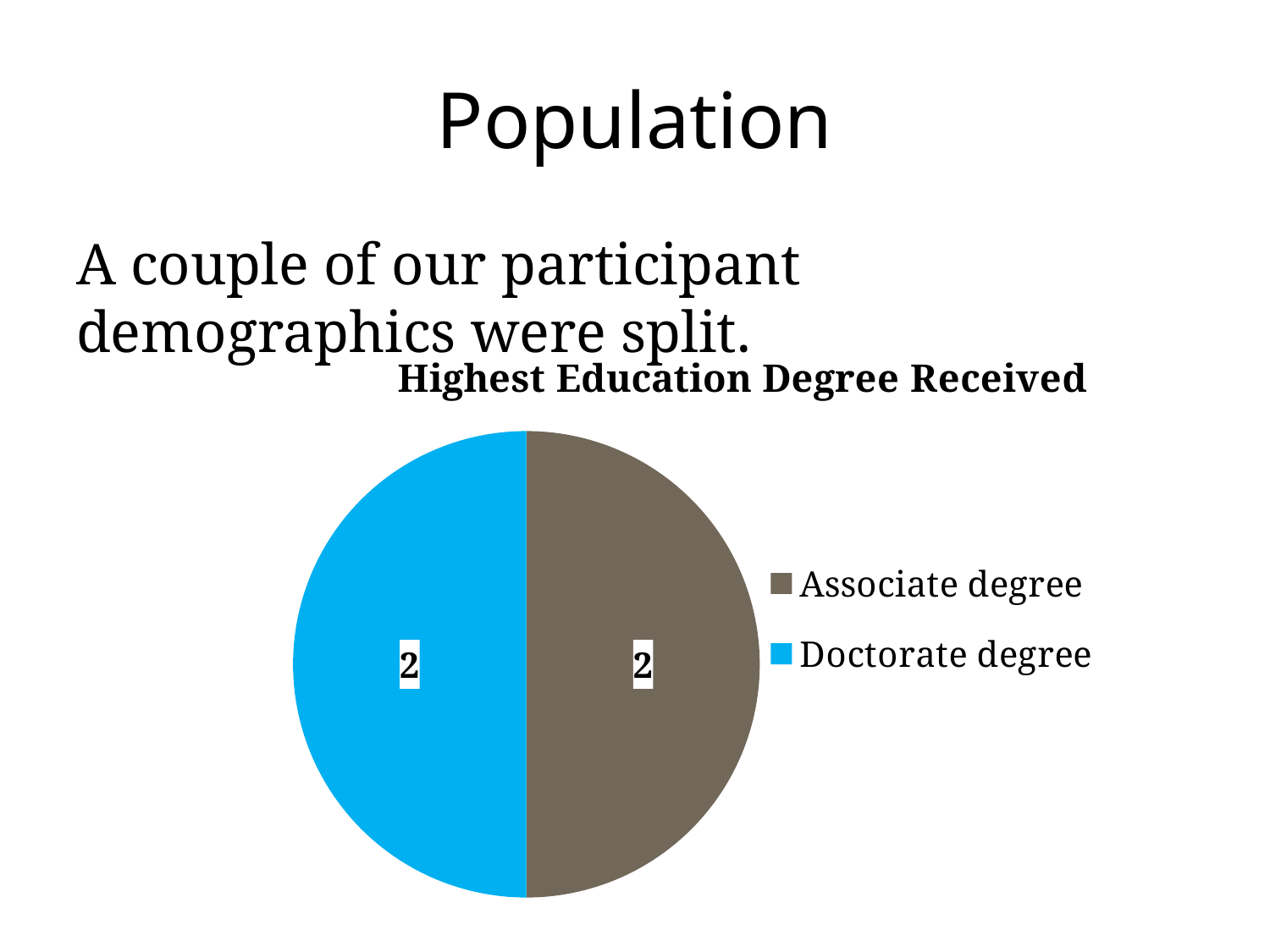
What kind of chart is shown on the slide? pie chart What is the title of the chart? Highest Education Degree Received What share of the pie does the Doctorate degree slice represent? 50% What is the total of all slices in the pie chart? 4 What is the value for Doctorate degree? 2 What is the value for Associate degree? 2 What is the difference between the values for Associate degree and Doctorate degree? 0 Which colour represents Doctorate degree in the chart? blue How many slices does the pie chart have? 2 What share of the pie does the Associate degree slice represent? 50%